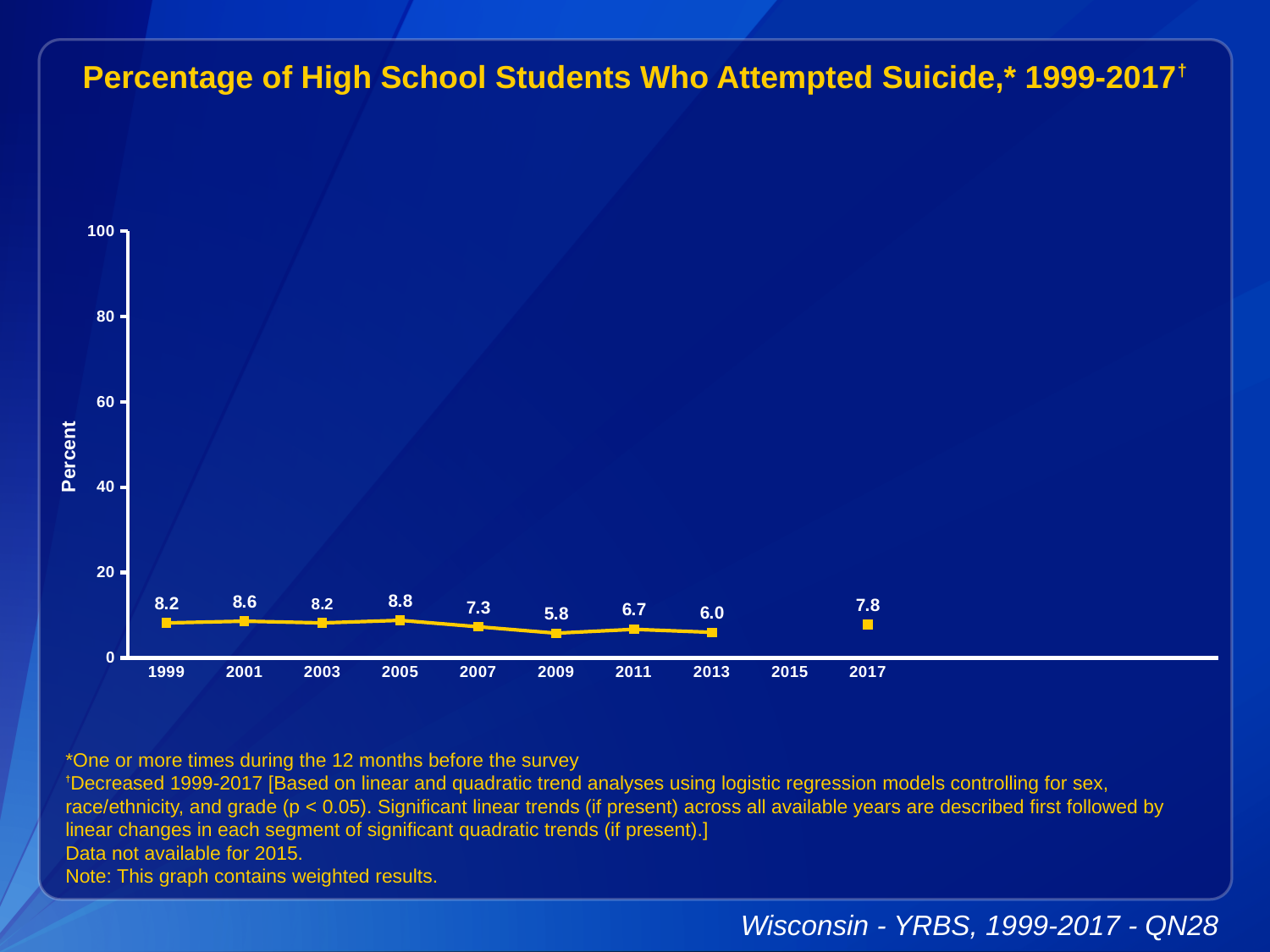
Which year on the x axis has no data point plotted? 2015 Did the percentage rise or fall from 1999 to 2013? fall What kind of chart is shown on the slide? line chart What is the value plotted for 2009? 5.8 Which year has a larger value, 2001 or 2013? 2001 What percentage of high school students attempted suicide in 1999? 8.2 What is the value plotted for 2017? 7.8 What is the difference between the 2005 value and the 2009 value? 3.0 Which year has the lowest percentage of students who attempted suicide? 2009 Which year has the highest percentage of students who attempted suicide? 2005 Is the value for 2005 greater or less than 20? less How many years have a data point plotted on the chart? 9